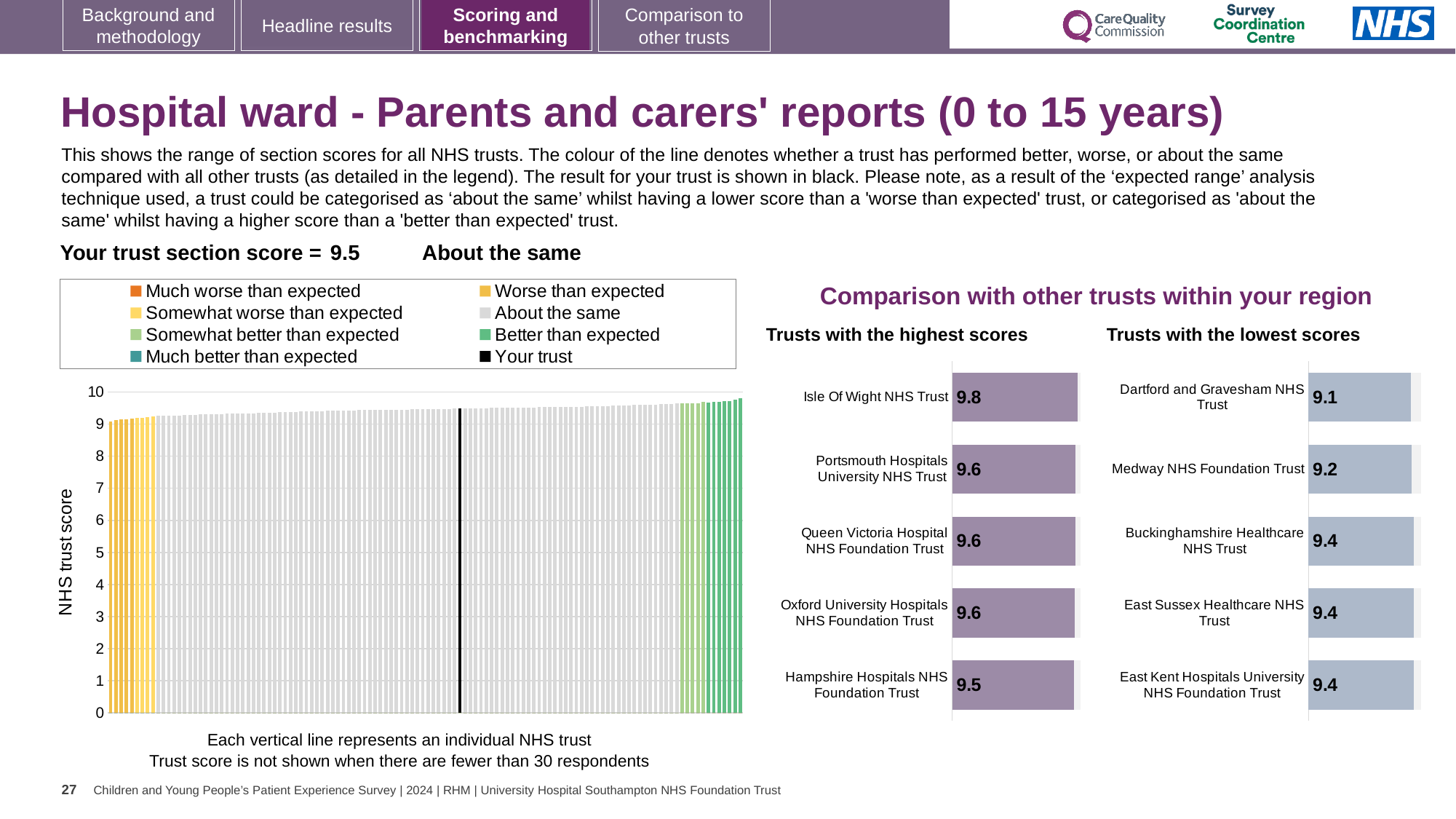
In the 'Trusts with the lowest scores' chart, what is the score for Medway NHS Foundation Trust? 9.2 In the 'Trusts with the lowest scores' chart, what is the difference between the scores of Buckinghamshire Healthcare NHS Trust and Dartford and Gravesham NHS Trust? 0.3 In the 'Trusts with the highest scores' chart, what is the difference between the scores of Isle Of Wight NHS Trust and Hampshire Hospitals NHS Foundation Trust? 0.3 How many trusts are listed in the 'Trusts with the highest scores' chart? 5 How many entries does the legend of the 'NHS trust score' chart on the left list? 8 In the 'Trusts with the highest scores' chart, what is the score for Isle Of Wight NHS Trust? 9.8 How many trusts are listed in the 'Trusts with the lowest scores' chart? 5 In the 'NHS trust score' chart on the left, what is the section score for your trust (shown in black)? 9.5 In the 'Trusts with the highest scores' chart, which trust has the highest score? Isle Of Wight NHS Trust Which is larger: the score for Portsmouth Hospitals University NHS Trust in the highest scores chart or the score for Medway NHS Foundation Trust in the lowest scores chart? Portsmouth Hospitals University NHS Trust In the 'Trusts with the lowest scores' chart, which trust has the lowest score? Dartford and Gravesham NHS Trust What kind of chart is the 'NHS trust score' chart on the left of the slide? Bar chart